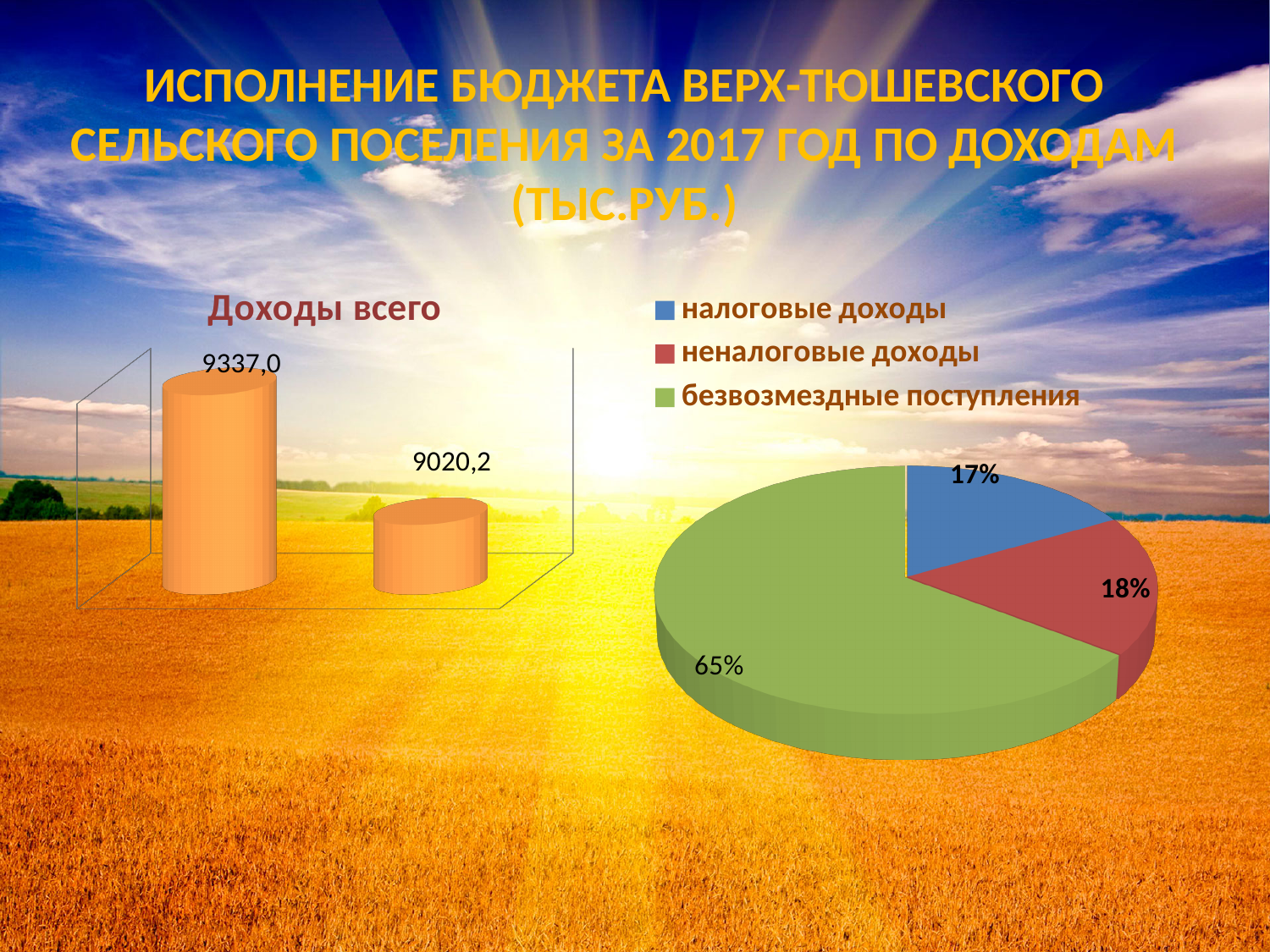
In the 'Доходы всего' chart, which bar is taller, the left one or the right one? the left one In the pie chart on the right, what share is shown for 'налоговые доходы'? 17% In the 'Доходы всего' chart, what value is shown on the left bar? 9337,0 What kind of chart is the 'Доходы всего' chart on the left of the slide? bar chart How many bars are plotted in the 'Доходы всего' chart? 2 In the 'Доходы всего' chart, what is the difference between the two bar values? 316,8 In the 'Доходы всего' chart, what value is shown on the right bar? 9020,2 In the pie chart on the right, what share is shown for 'неналоговые доходы'? 18% In the pie chart on the right, what share is shown for 'безвозмездные поступления'? 65% How many entries does the legend of the pie chart on the right list? 3 In the pie chart on the right, what colour is the slice for 'безвозмездные поступления'? green In the pie chart on the right, which category has the largest slice? безвозмездные поступления